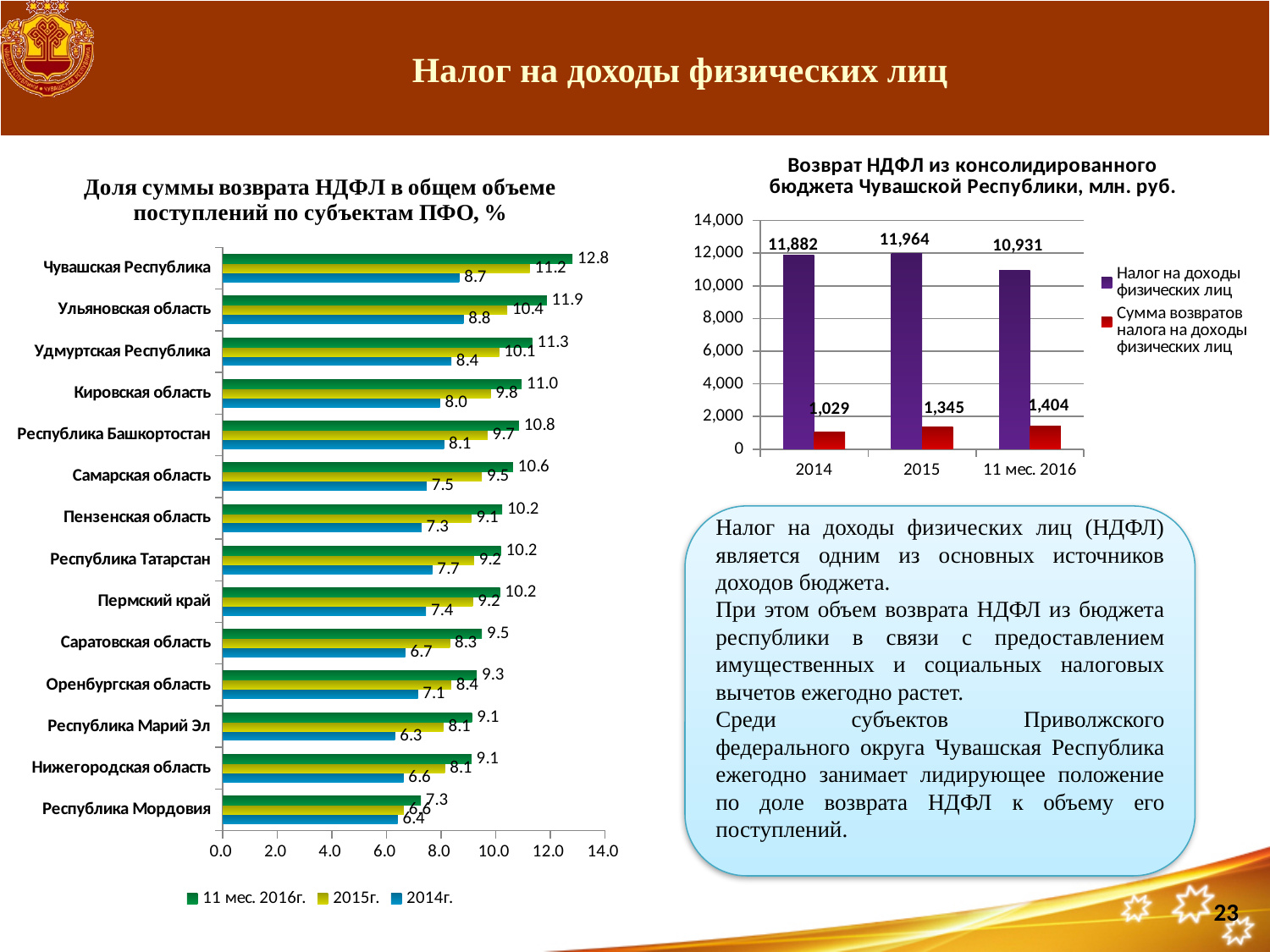
On the left chart (Доля суммы возврата НДФЛ...), which region has the lowest value for 11 мес. 2016г.? Республика Мордовия On the right chart (Возврат НДФЛ из консолидированного бюджета...), what is the value of Сумма возвратов налога на доходы физических лиц for 11 мес. 2016? 1,404 On the left chart (Доля суммы возврата НДФЛ...), how many series does the legend list? 3 On the left chart (Доля суммы возврата НДФЛ...), what is the 2014г. value for Ульяновская область? 8.8 On the left chart (Доля суммы возврата НДФЛ...), which region has the highest 2015г. value? Чувашская Республика What kind of chart is the right chart (Возврат НДФЛ из консолидированного бюджета Чувашской Республики, млн. руб.)? bar chart On the right chart (Возврат НДФЛ из консолидированного бюджета Чувашской Республики, млн. руб.), what is the value of Налог на доходы физических лиц for 2015? 11,964 On the left chart (Доля суммы возврата НДФЛ...), how many regions are listed? 14 On the right chart (Возврат НДФЛ из консолидированного бюджета...), what is the difference between Налог на доходы физических лиц in 2014 and in 11 мес. 2016? 951 On the left chart (Доля суммы возврата НДФЛ в общем объеме поступлений по субъектам ПФО, %), what is the value for Чувашская Республика for 11 мес. 2016г.? 12.8 On the right chart (Возврат НДФЛ из консолидированного бюджета...), do the values of Сумма возвратов налога на доходы физических лиц rise or fall from 2014 to 11 мес. 2016? rise On the left chart (Доля суммы возврата НДФЛ...), what is the difference between the 11 мес. 2016г. and 2014г. values for Кировская область? 3.0